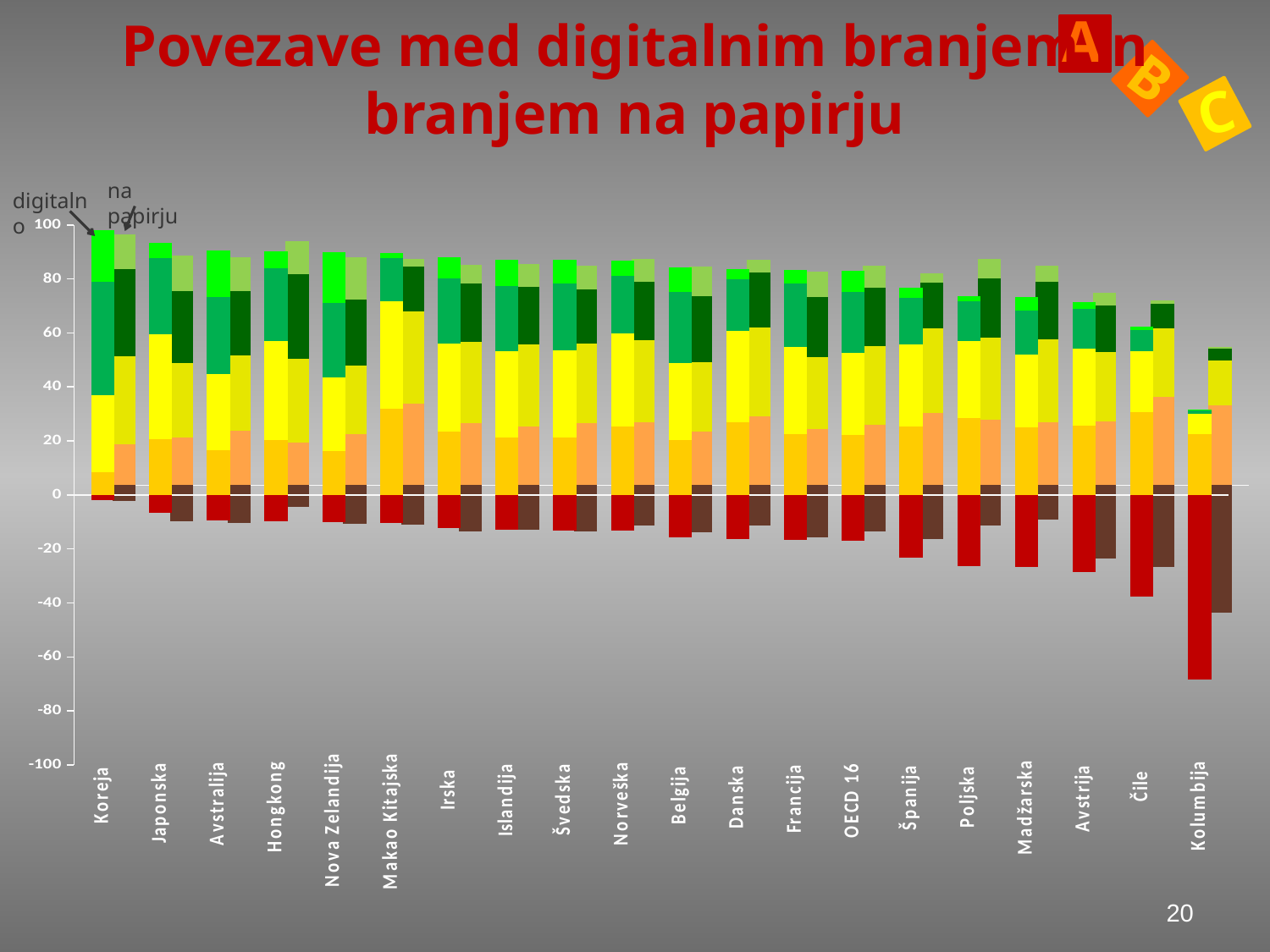
Which country has the lowest (most negative) red bar below zero? Kolumbija Is the bottom of the red (digitalno) bar for Kolumbija greater or less than -60? less Which category is listed last on the x axis? Kolumbija Is the top of the stacked digitalno bar for Koreja greater or less than 80? greater Is the bottom of the red (digitalno) bar for Čile greater or less than -20? less How many countries/categories are shown along the x axis of the chart? 20 Which category is listed first on the x axis? Koreja Which country's stacked bars reach the highest point above zero? Koreja Which two bar groups are labelled at the top left of the chart? digitalno and na papirju What is the title of the chart slide? Povezave med digitalnim branjem in branjem na papirju Moving from Koreja on the left to Kolumbija on the right, do the tops of the stacked bars generally rise or fall? fall What kind of chart is shown on the slide? bar chart